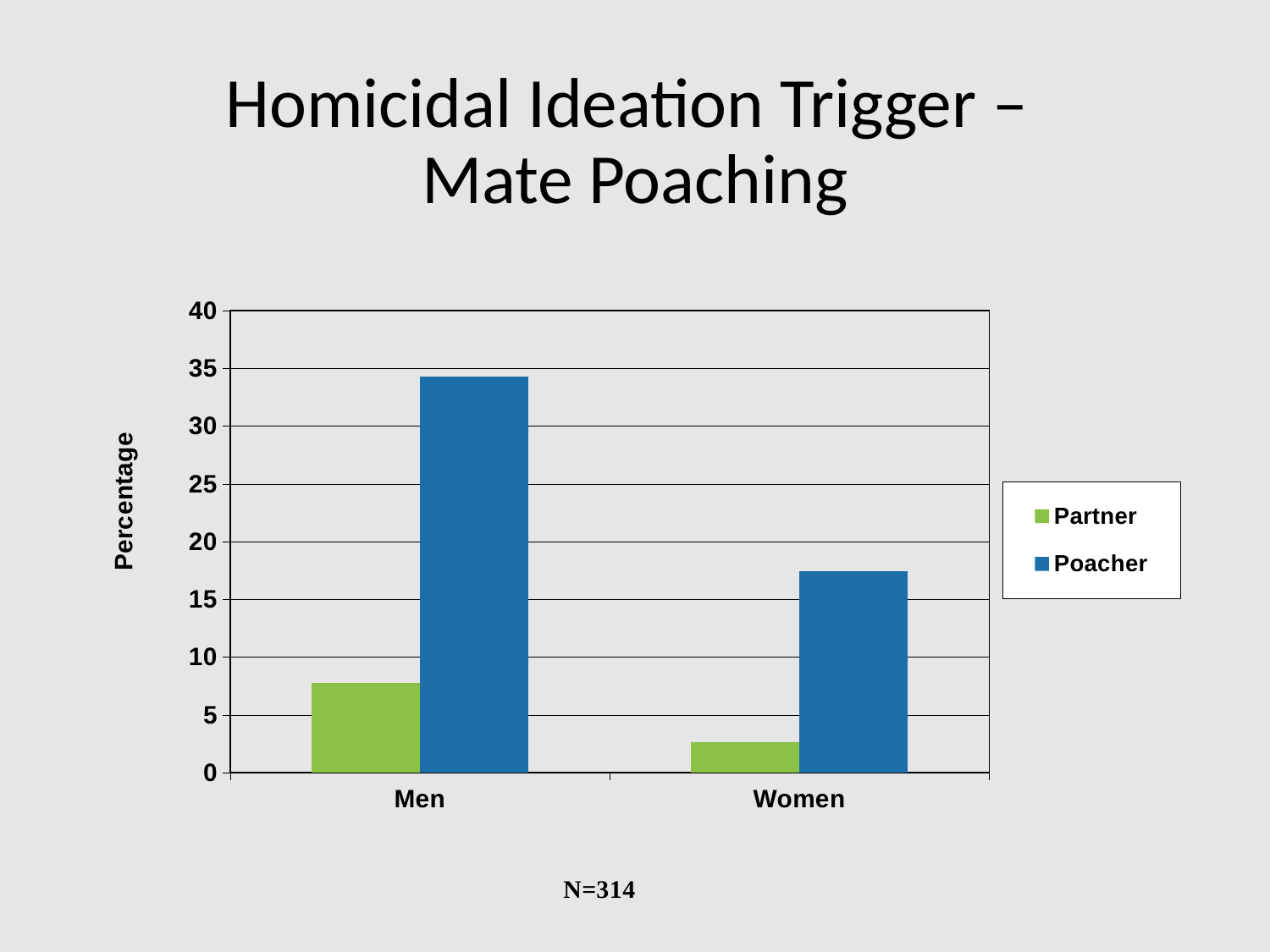
What kind of chart is shown on the slide? bar chart Is the Partner value for Men greater or less than 10? less Which category has the highest Poacher value? Men Is the Poacher value for Men greater or less than 30? greater How many categories are shown on the x axis? 2 How many series does the legend list? 2 Which is larger, the Partner value for Men or the Poacher value for Women? Poacher value for Women Which category has the lowest Partner value? Women For Women, which is larger, the Partner value or the Poacher value? Poacher Is the Partner value for Women greater or less than 5? less What is the label on the vertical axis? Percentage